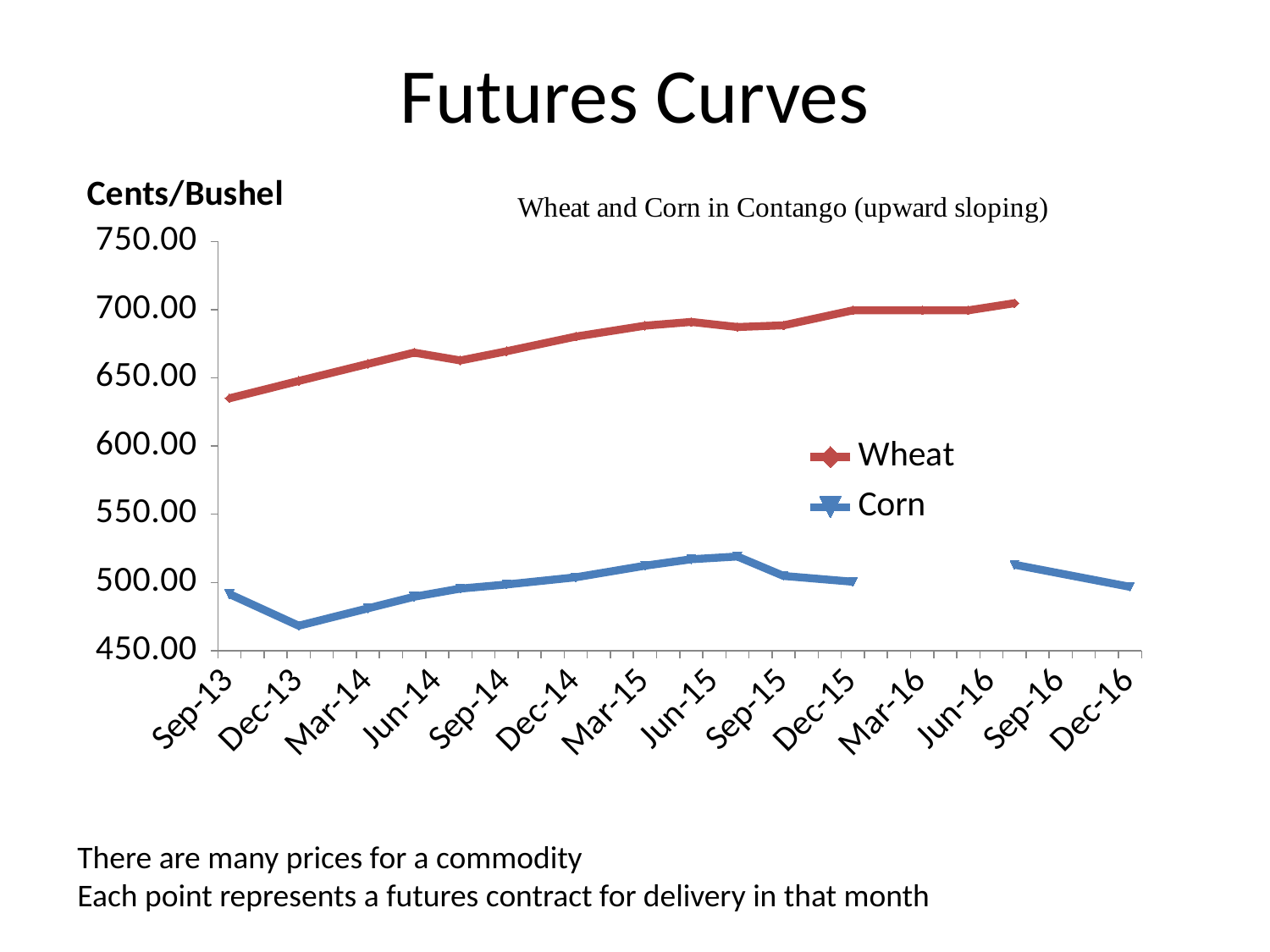
Is the Wheat value for Mar-15 greater or less than 650? greater Is the Corn value for Dec-13 greater or less than 500? less Is the Wheat value for Sep-13 greater or less than 600? greater What is the label on the vertical axis of the chart? Cents/Bushel Which two series are shown in the legend? Wheat and Corn How many series does the legend list? 2 Which series has the higher value at Jun-14, Wheat or Corn? Wheat Does the Wheat series generally rise or fall from Sep-13 to Jun-16? Rise For Corn, which is larger: the value at Dec-13 or the value at Jun-15? Jun-15 At which delivery month is the Corn value lowest? Dec-13 What kind of chart is shown on the slide? Line chart